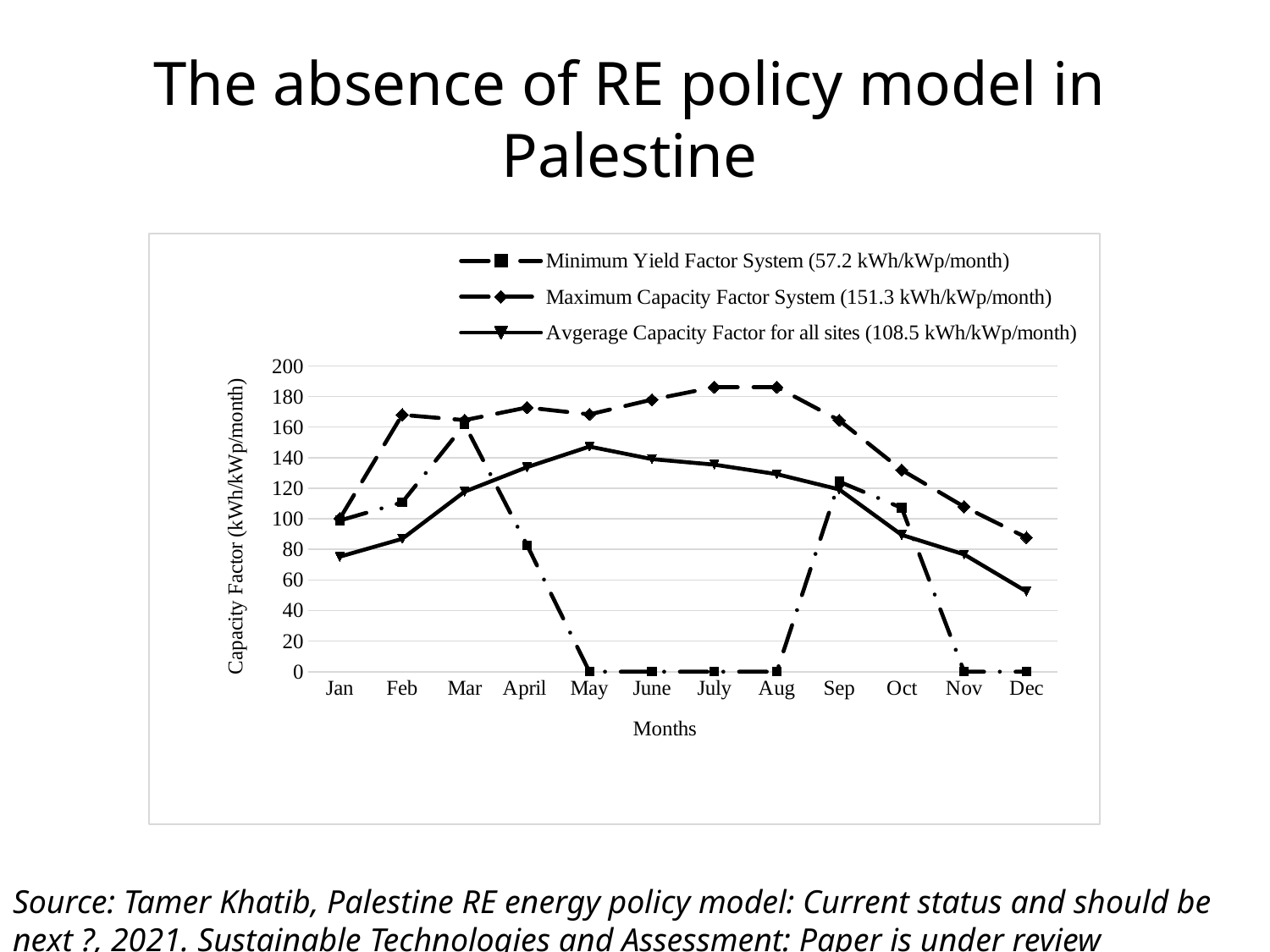
Does the Avgerage Capacity Factor for all sites rise or fall from May to Dec? fall What value does the legend give for the Minimum Yield Factor System? 57.2 kWh/kWp/month In which month is the Minimum Yield Factor System at its highest? Mar What is the value of the Minimum Yield Factor System in Nov? 0 Is the value for the Maximum Capacity Factor System in July greater or less than 180? greater How many series does the legend list? 3 How many months are plotted along the x axis? 12 In which month is the Avgerage Capacity Factor for all sites at its lowest? Dec What is the value of the Minimum Yield Factor System in June? 0 What kind of chart is shown on the slide? line chart Is the value for the Minimum Yield Factor System in April greater or less than 100? less In Jan, which is larger: the Maximum Capacity Factor System or the Avgerage Capacity Factor for all sites? Maximum Capacity Factor System